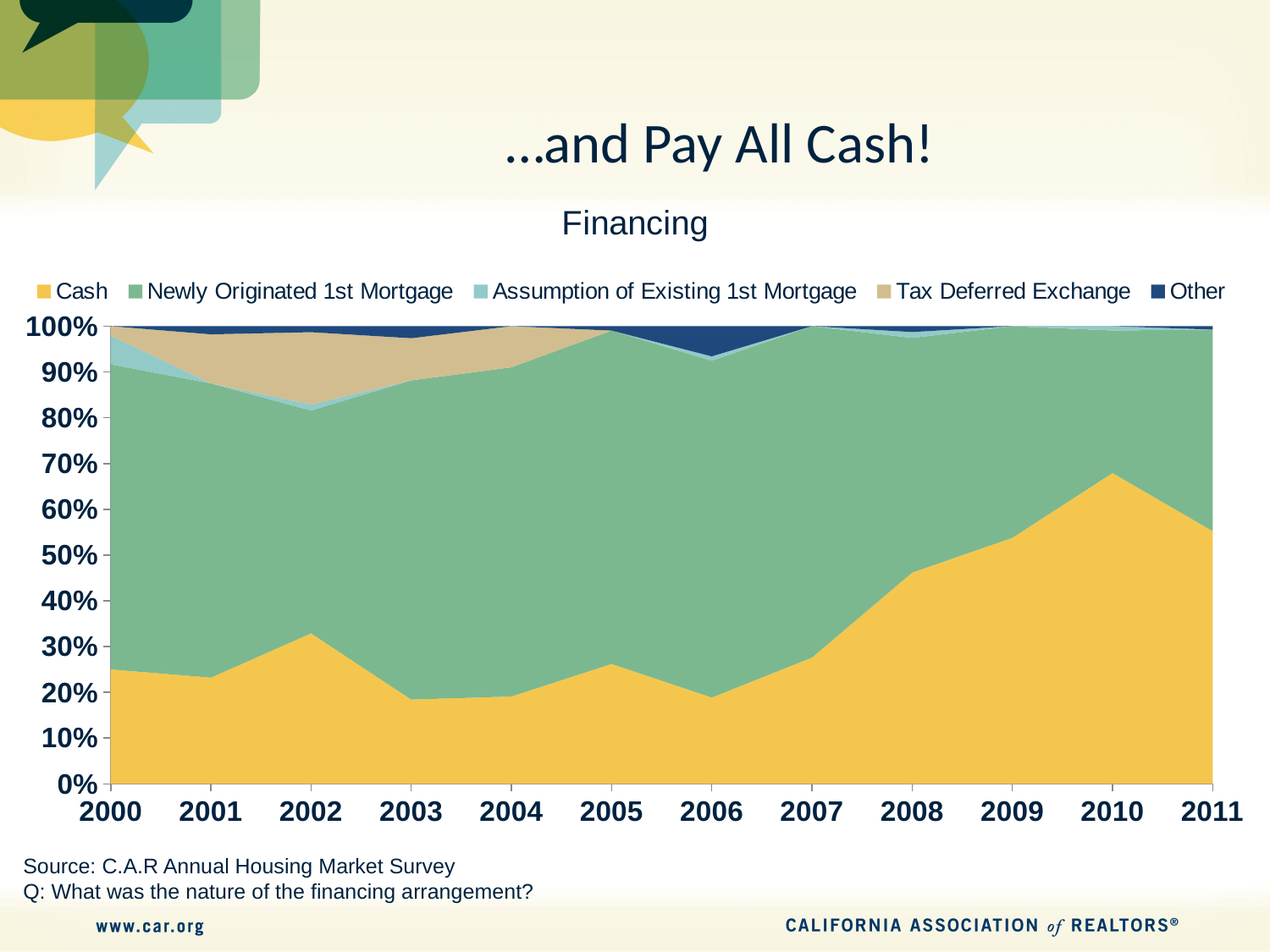
What kind of chart is shown on the slide? Stacked area chart Which series is shown in yellow? Cash Is the Cash share in 2000 greater or less than 30%? less Does the Cash share rise or fall from 2006 to 2010? rise What is the title of the chart? Financing Which year has the larger Cash share, 2000 or 2010? 2010 How many years are shown along the x axis? 12 Is the Cash share in 2008 greater or less than 40%? greater Is the Cash share in 2011 greater or less than 50%? greater How many series does the legend list? 5 Which year has the highest share for Cash? 2010